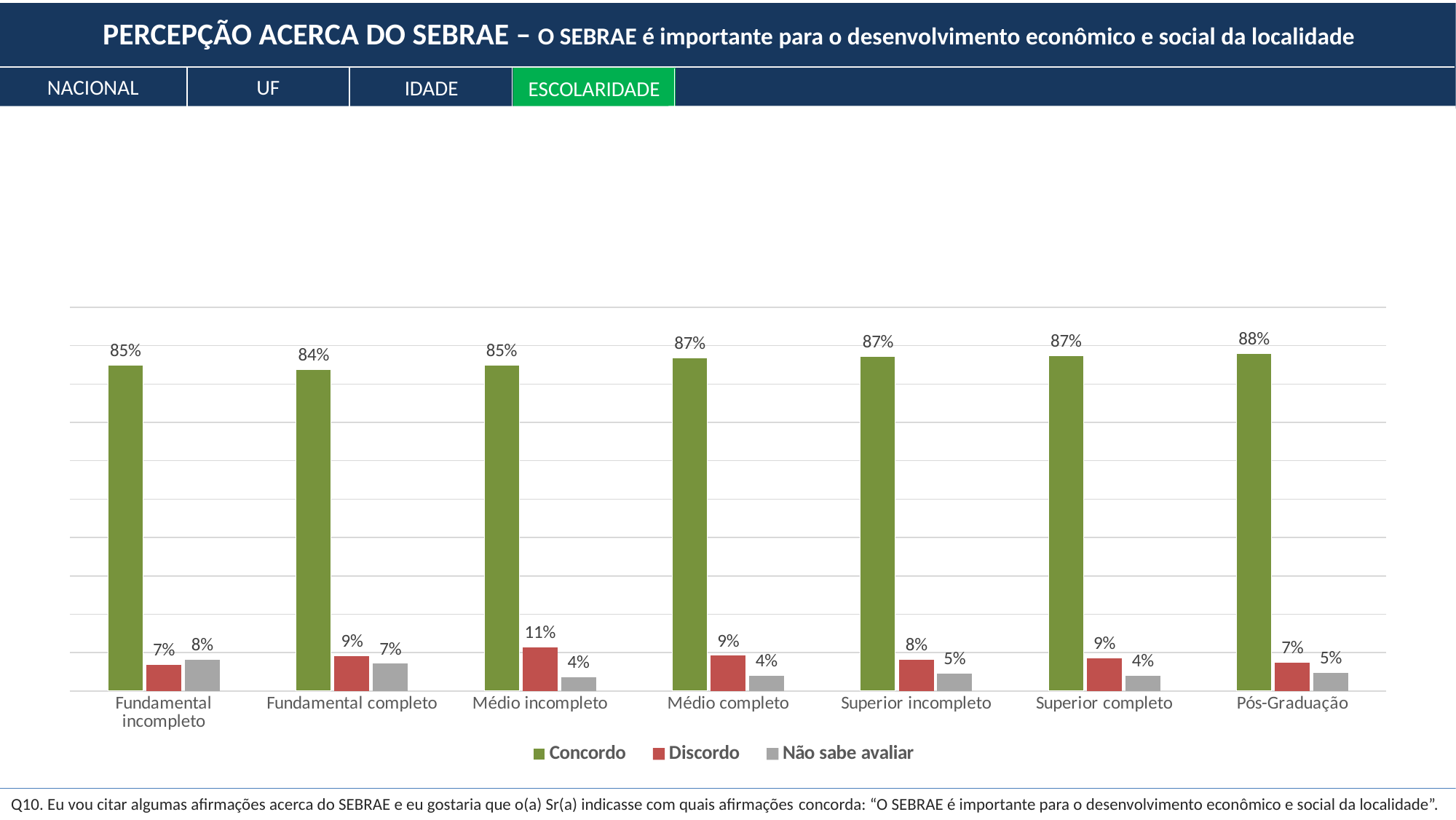
What is the Discordo value for Médio incompleto? 11% Which category has the highest Discordo value? Médio incompleto Which category has the lowest Concordo value? Fundamental completo What is the Concordo value for Pós-Graduação? 88% What kind of chart is shown on the slide? Bar chart Which tab is highlighted in green above the chart? ESCOLARIDADE What is the difference between the Concordo values for Pós-Graduação and Fundamental completo? 4% Which is larger, the Discordo value for Fundamental completo or the Discordo value for Pós-Graduação? Fundamental completo How many education categories are shown on the x axis? 7 How many series does the legend list? 3 What is the Não sabe avaliar value for Fundamental incompleto? 8% Which category has the highest Concordo value? Pós-Graduação